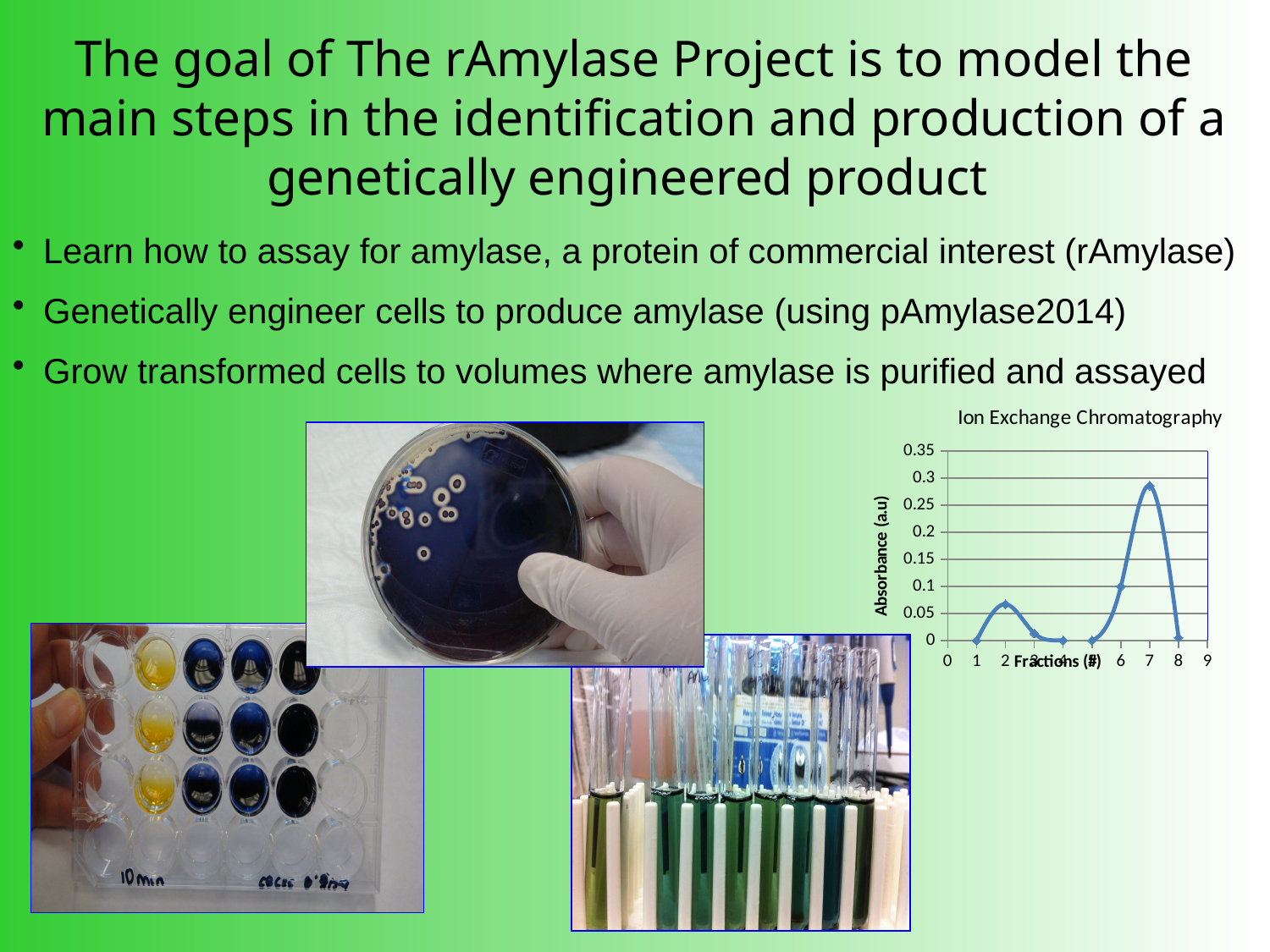
On the Ion Exchange Chromatography chart, which fraction has the higher absorbance, fraction 2 or fraction 7? fraction 7 What is the title of the chart on the slide? Ion Exchange Chromatography On the Ion Exchange Chromatography chart, does the absorbance rise or fall from fraction 7 to fraction 8? fall On the Ion Exchange Chromatography chart, is the absorbance at fraction 7 greater or less than 0.25? greater At which fraction number is the absorbance highest on the Ion Exchange Chromatography chart? 7 On the Ion Exchange Chromatography chart, is the absorbance at fraction 6 greater or less than 0.15? less What kind of chart is the Ion Exchange Chromatography chart? line chart On the Ion Exchange Chromatography chart, is the absorbance at fraction 2 greater or less than 0.1? less How many data points are plotted on the Ion Exchange Chromatography chart? 8 What is the label of the y axis on the Ion Exchange Chromatography chart? Absorbance (a.u)